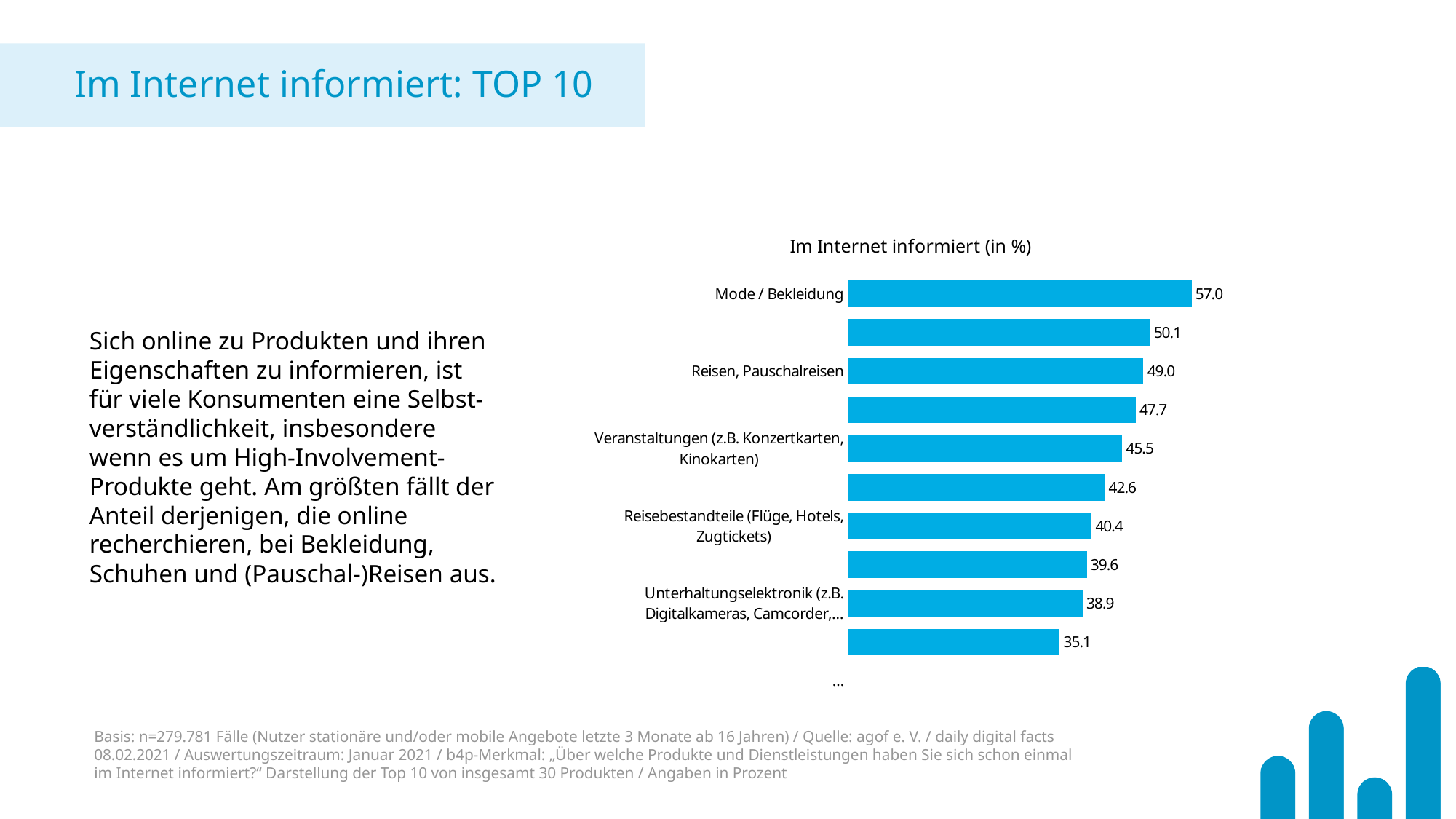
What is the value for Veranstaltungen (z.B. Konzertkarten, Kinokarten)? 45.5 What is the value for Reisebestandteile (Flüge, Hotels, Zugtickets)? 40.4 What type of chart is shown on the slide? bar chart What is the value for Unterhaltungselektronik (z.B. Digitalkameras, Camcorder,...)? 38.9 Which category has the highest value? Mode / Bekleidung What is the value for Reisen, Pauschalreisen? 49.0 What is the title of the chart? Im Internet informiert (in %) What is the difference between the values for Mode / Bekleidung and Reisen, Pauschalreisen? 8.0 How many bars with data labels are plotted on the chart? 10 Which is larger, the value for Veranstaltungen (z.B. Konzertkarten, Kinokarten) or the value for Reisebestandteile (Flüge, Hotels, Zugtickets)? Veranstaltungen (z.B. Konzertkarten, Kinokarten) What is the lowest value labelled on the chart? 35.1 What is the value for Mode / Bekleidung? 57.0